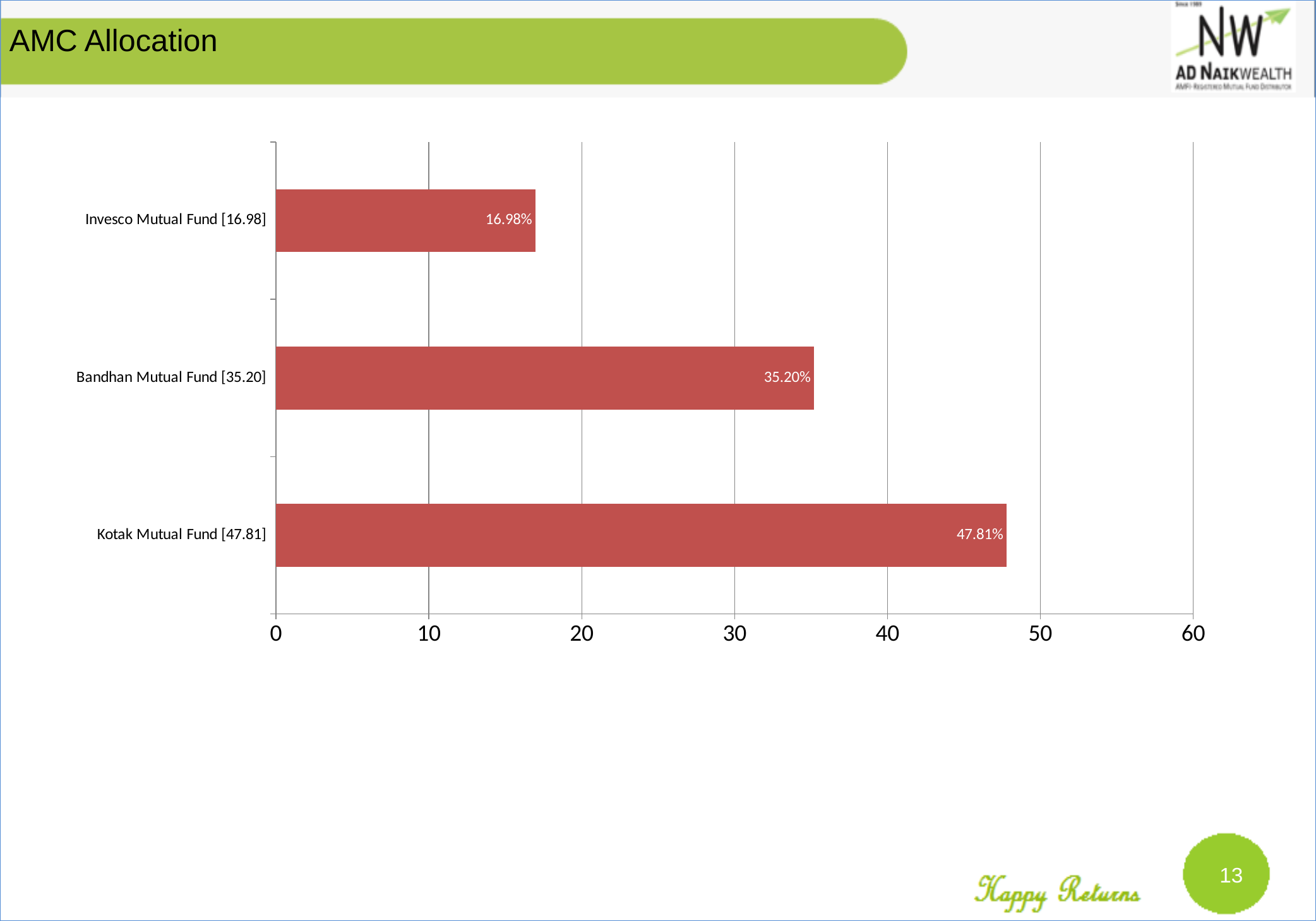
What is the difference between the values for Kotak Mutual Fund and Bandhan Mutual Fund? 12.61% What is the title of the slide? AMC Allocation Which fund has the highest allocation? Kotak Mutual Fund Which is larger, the value for Bandhan Mutual Fund or Invesco Mutual Fund? Bandhan Mutual Fund Is the value for Kotak Mutual Fund greater or less than 40? greater How many funds are shown in the chart? 3 What is the value for Bandhan Mutual Fund? 35.20% What is the value for Kotak Mutual Fund? 47.81% What is the difference between the values for Bandhan Mutual Fund and Invesco Mutual Fund? 18.22% Which fund has the lowest allocation? Invesco Mutual Fund What kind of chart is shown on the slide? Bar chart What is the value for Invesco Mutual Fund? 16.98%